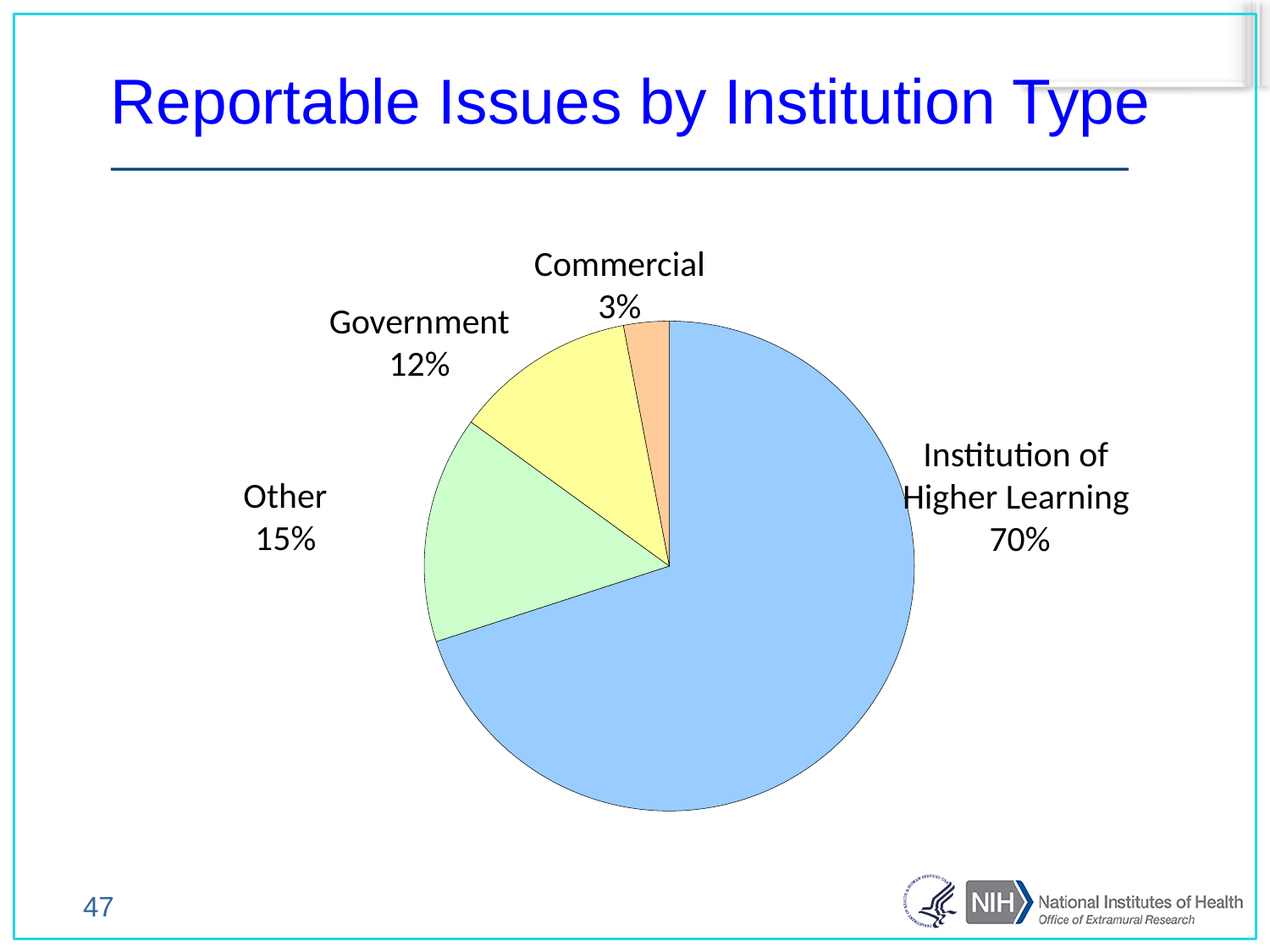
What percentage of reportable issues is attributed to Government? 12% What share of reportable issues comes from Institution of Higher Learning? 70% What is the title of the chart on the slide? Reportable Issues by Institution Type Which has a larger share, Government or Other? Other What percentage of reportable issues falls under Other? 15% What kind of chart is shown on the slide? pie chart What percentage of reportable issues is attributed to Commercial institutions? 3% Which institution type has the smallest share of reportable issues? Commercial What is the difference in percentage points between Other and Government? 3 Which institution type has the largest share of reportable issues? Institution of Higher Learning What is the difference in percentage points between Institution of Higher Learning and Commercial? 67 How many institution types are shown in the pie chart? 4